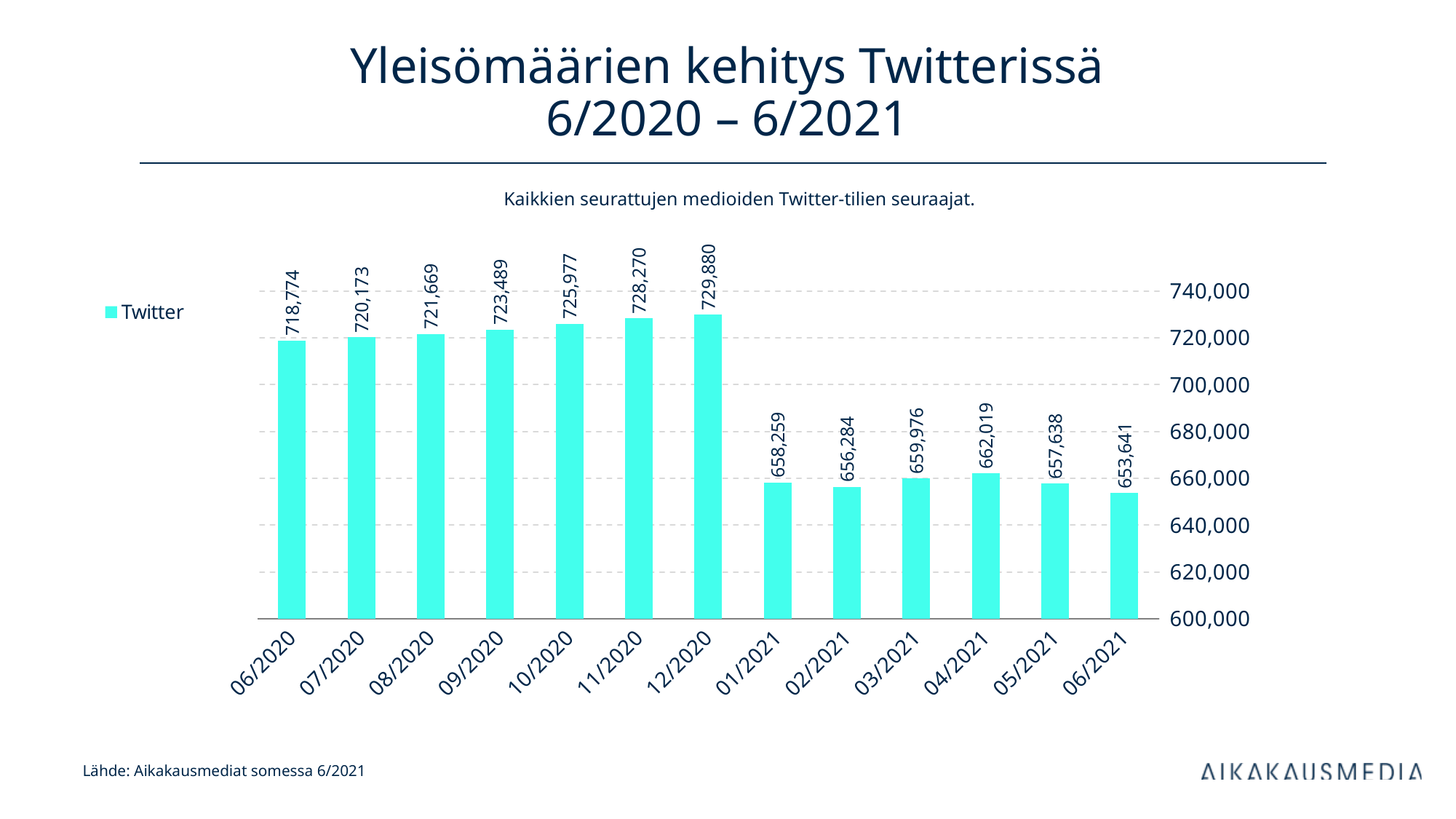
What is the value for 12/2020? 729,880 What is the value for 06/2021? 653,641 Which month has the lowest value? 06/2021 Do the values rise or fall from 06/2020 to 12/2020? rise What is the value for 01/2021? 658,259 Which is larger, the value for 04/2021 or the value for 02/2021? 04/2021 Which month has the highest value? 12/2020 What is the difference between the values for 12/2020 and 01/2021? 71,621 Is the value for 03/2021 greater or less than 700,000? less How many months are shown on the x axis? 13 What is the value for 06/2020? 718,774 What kind of chart is shown on the slide? bar chart